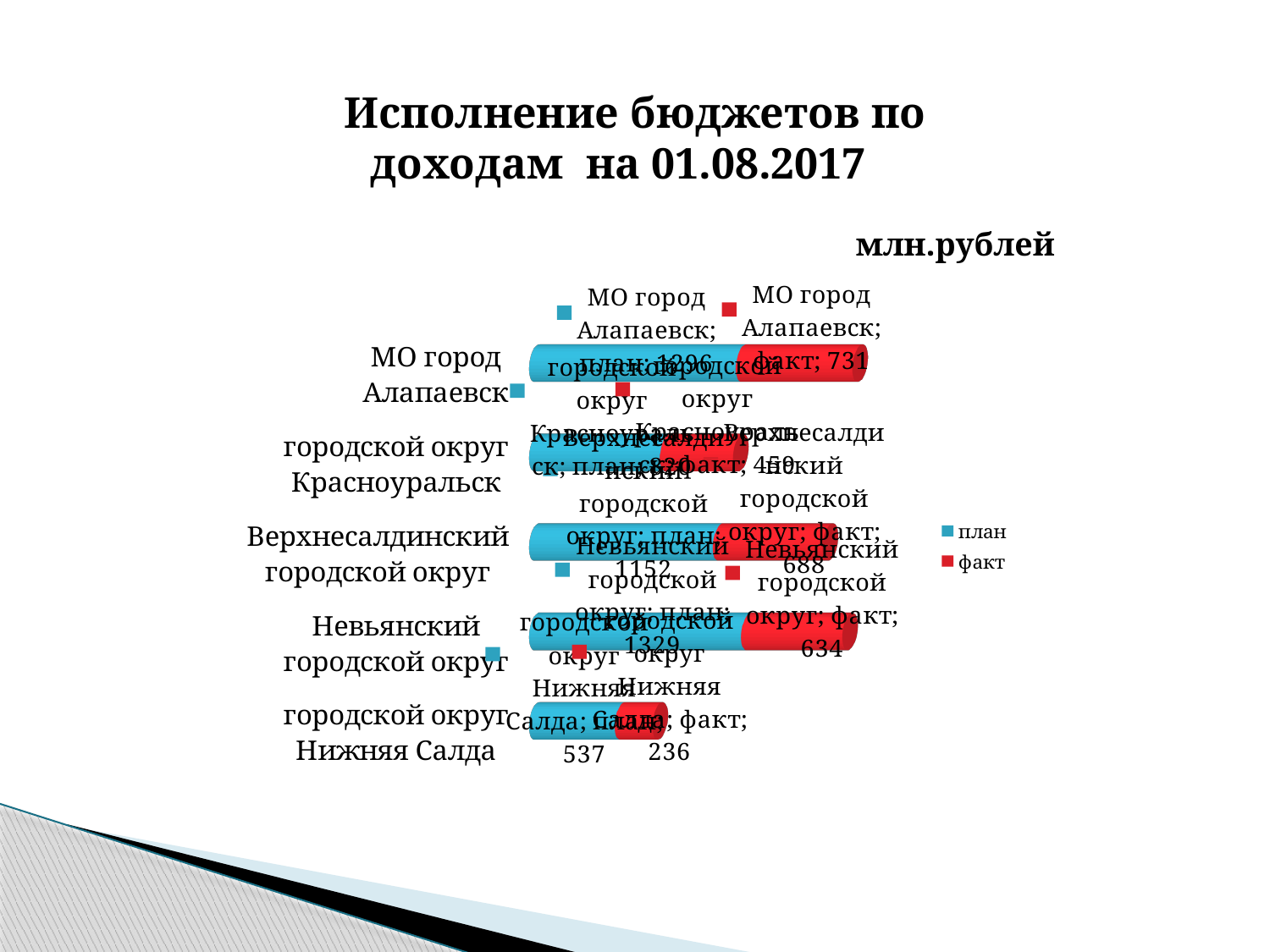
Which category has the lowest факт value? городской округ Нижняя Салда What is the факт value for городской округ Нижняя Салда? 236 What is the факт value for МО город Алапаевск? 731 What is the план value for МО город Алапаевск? 1296 What kind of chart is shown on the slide? bar chart Which is larger, the план value for Невьянский городской округ or for МО город Алапаевск? Невьянский городской округ How many series does the legend list? 2 What is the difference between план and факт for МО город Алапаевск? 565 What is the total of план and факт for городской округ Нижняя Салда? 773 How many categories are shown in the chart? 5 What is the факт value for Верхнесалдинский городской округ? 688 What is the план value for Невьянский городской округ? 1329